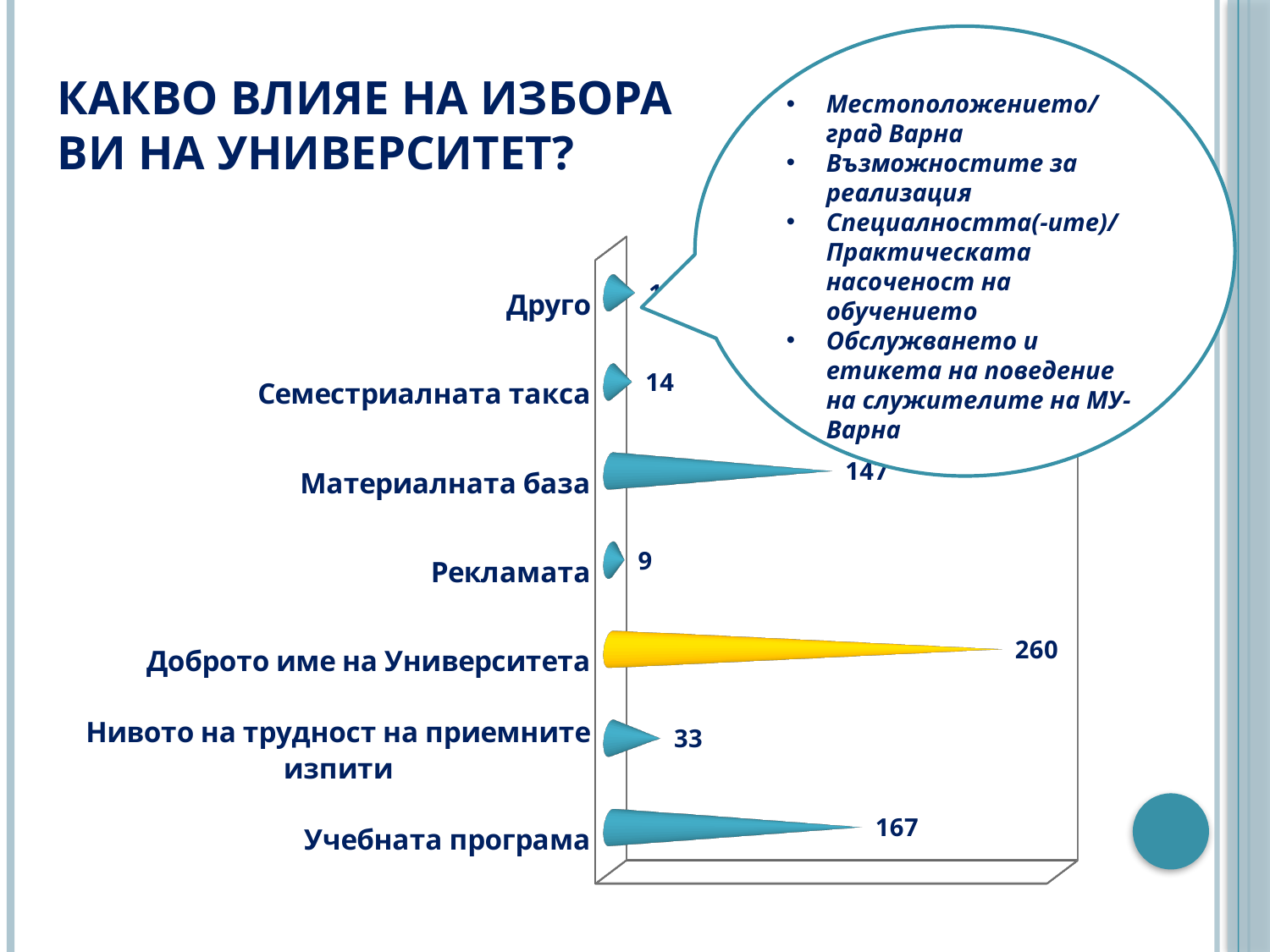
What value is shown for Рекламата? 9 What value is shown for Семестриалната такса? 14 What value is shown for Материалната база? 147 What value is shown for Учебната програма? 167 What is the difference between the values for Доброто име на Университета and Учебната програма? 93 Which category has the highest value? Доброто име на Университета How many categories are shown in the chart? 7 Which category has the lowest labelled value? Рекламата What value is shown for Доброто име на Университета? 260 Which is larger, the value for Материалната база or the value for Учебната програма? Учебната програма What value is shown for Нивото на трудност на приемните изпити? 33 What kind of chart is shown on the slide? Bar chart